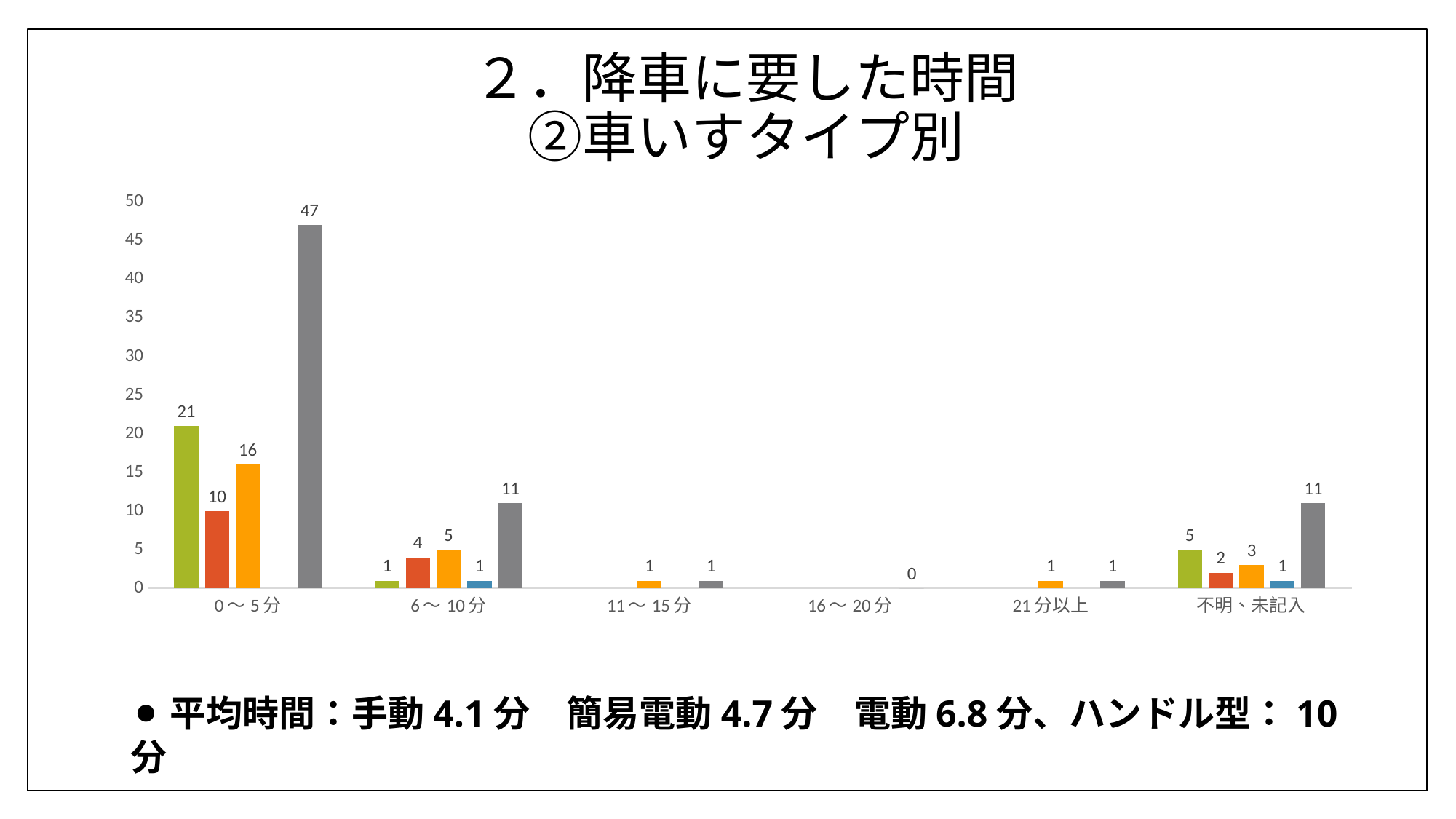
What is the value of the orange bar for the 6～10分 category? 5 In the 0～5分 category, which is larger, the red bar or the orange bar? the orange bar What type of chart is shown on the slide? bar chart Which category has the tallest bar in the chart? 0～5分 What is the difference between the gray bar for 0～5分 and the gray bar for 6～10分? 36 What is the difference between the gray bar and the green bar in the 0～5分 category? 26 What is the value of the gray bar for the 0～5分 category? 47 What is the title of the slide containing the chart? ２．降車に要した時間 ②車いすタイプ別 What is the value of the green bar for the 0～5分 category? 21 What is the value of the gray bar for the 不明、未記入 category? 11 What value is labelled for the 16～20分 category? 0 How many categories are shown on the x axis of the chart? 6